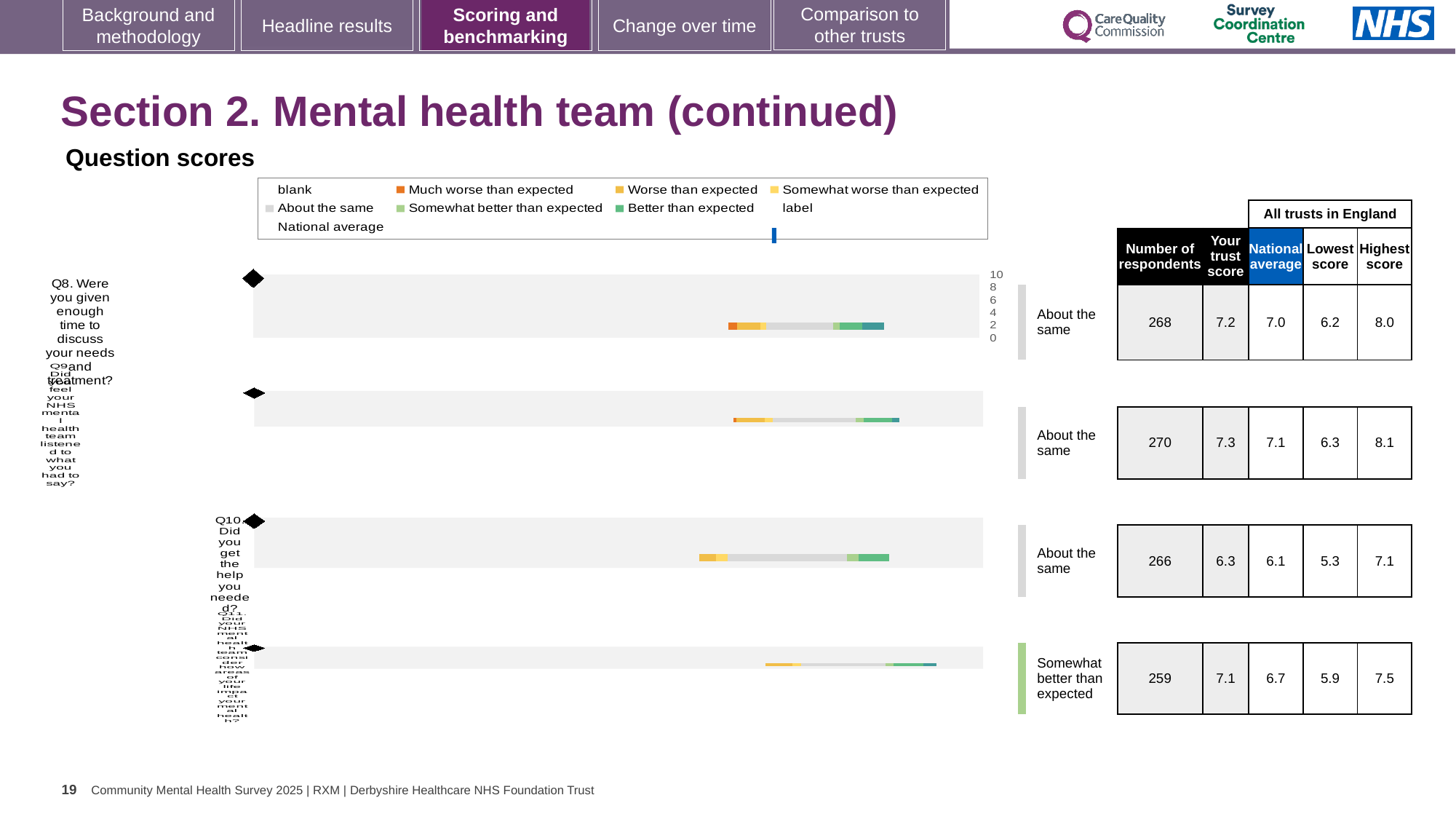
What benchmark category is shown for Q11 (the fourth row)? Somewhat better than expected What is the national average for Q9 (the second row)? 7.1 How many questions (rows) are shown in the question scores section? 4 In the legend, what colour represents 'Much worse than expected'? orange What is the lowest score across all trusts in England for Q10 (Did you get the help you needed?)? 5.3 Which question has the lowest 'Your trust score'? Q10 Which question has the highest 'Your trust score'? Q9 What is the 'Your trust score' for Q8 (Were you given enough time to discuss your needs and treatment?)? 7.2 What kind of chart is used to show the question scores on this slide? bar chart What is the difference between the highest score and the lowest score for Q8? 1.8 How many respondents answered Q11 (the fourth row)? 259 For Q11 (the fourth row), which is larger: the trust score or the national average? the trust score